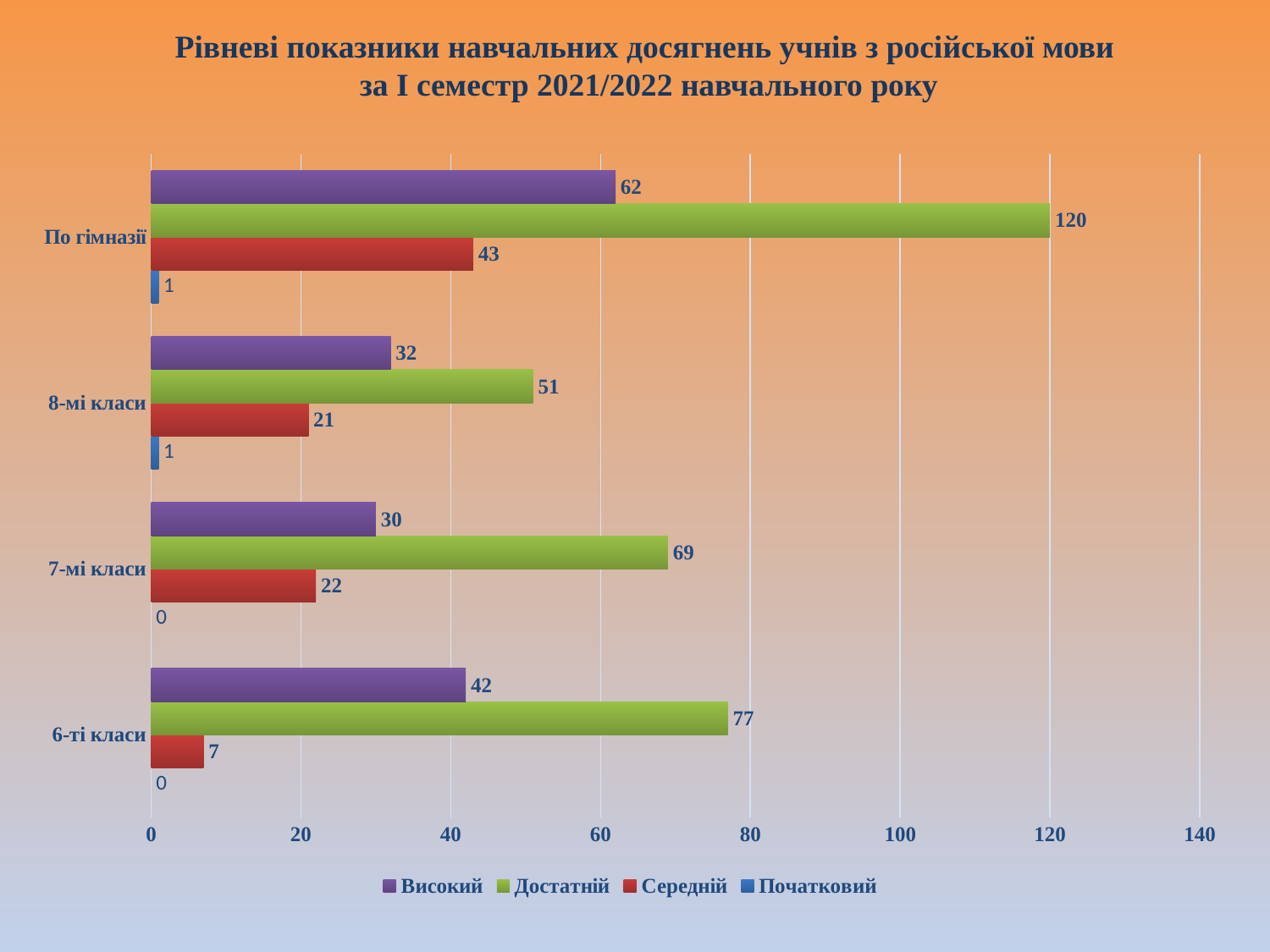
Which category has the highest Достатній value? По гімназії What is the value of Початковий for 7-мі класи? 0 Which is larger: Високий for 8-мі класи or Високий for 7-мі класи? 8-мі класи Which series is shown in green in the legend? Достатній How many series does the legend list? 4 What kind of chart is shown on the slide? bar chart What is the value of Високий for 6-ті класи? 42 What is the difference between the Достатній values for 6-ті класи and 7-мі класи? 8 What is the value of Достатній for По гімназії? 120 Which category has the lowest Середній value? 6-ті класи What is the value of Середній for 8-мі класи? 21 How many categories are shown on the y axis? 4